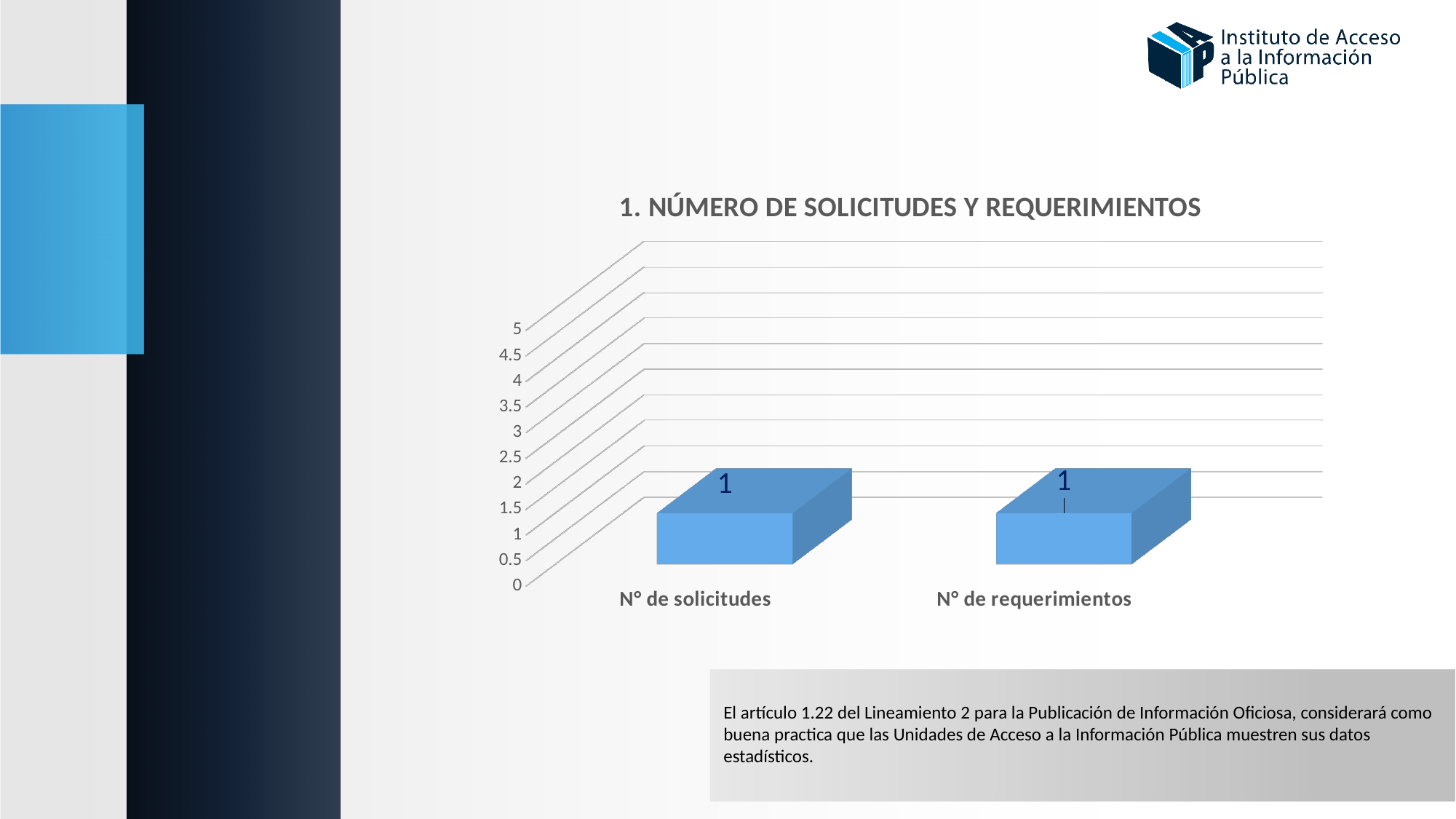
Is the value for N° de solicitudes greater or less than 3? less What is the value for N° de solicitudes? 1 What is the highest value shown on the vertical axis? 5 What kind of chart is shown on the slide? Bar chart How many categories are shown on the x axis? 2 What is the value for N° de requerimientos? 1 Is the value for N° de requerimientos greater or less than 2? less What is the difference between the values for N° de solicitudes and N° de requerimientos? 0 What is the total of the values for N° de solicitudes and N° de requerimientos? 2 What is the title of the chart? 1. NÚMERO DE SOLICITUDES Y REQUERIMIENTOS